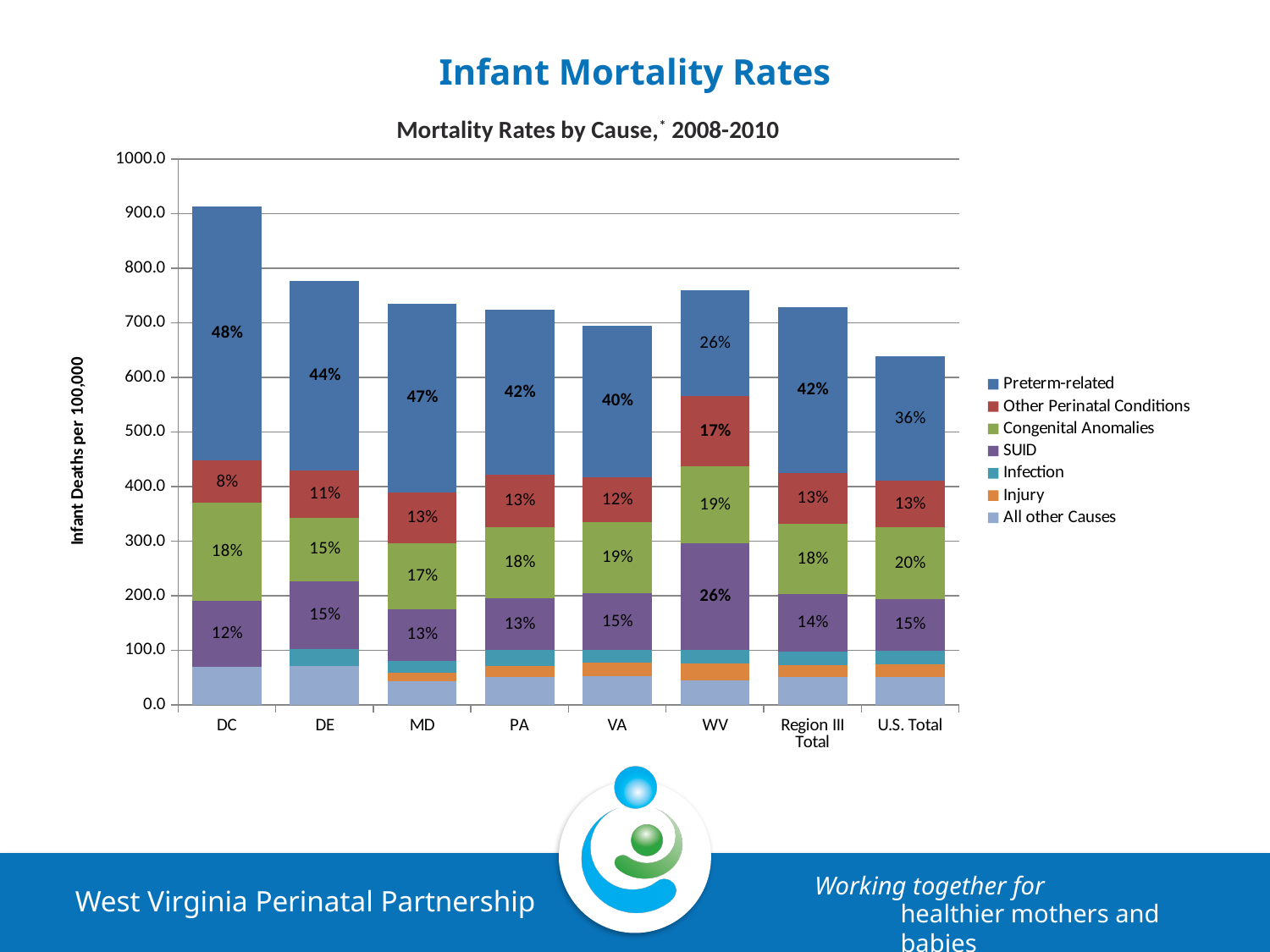
Which category has the shortest total bar? U.S. Total What percentage label is shown on the Preterm-related segment for DC? 48% Is the total bar height for U.S. Total greater or less than 700? less What percentage label is shown on the Congenital Anomalies segment for U.S. Total? 20% Is the total bar height for DC greater or less than 800? greater How many categories are shown along the x axis? 8 Which category has the tallest total bar? DC How many series does the legend list? 7 What percentage label is shown on the Other Perinatal Conditions segment for WV? 17% What kind of chart is shown on the slide? Stacked bar chart What percentage label is shown on the SUID segment for WV? 26% Which has the taller total bar, WV or VA? WV